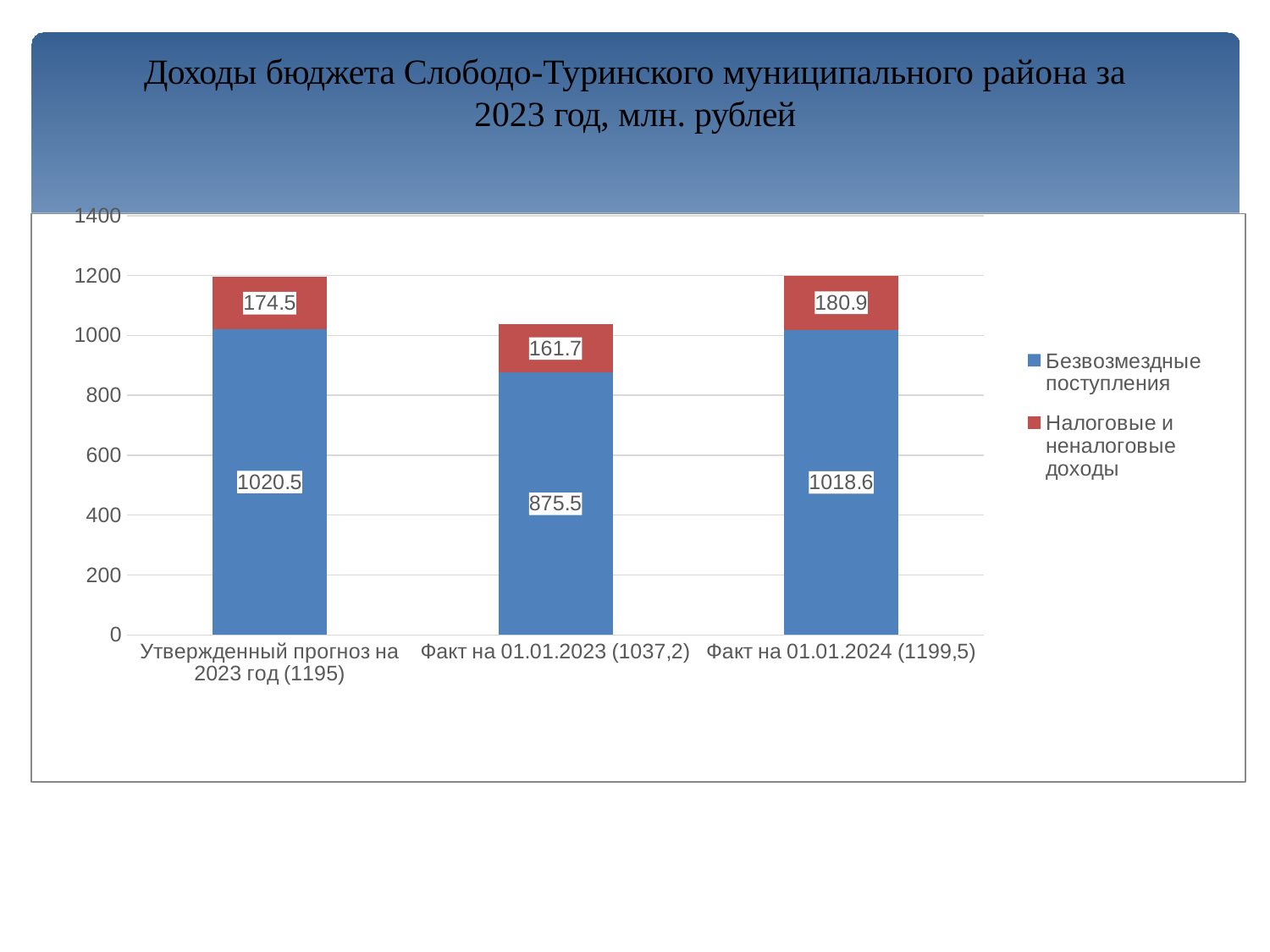
What is the value of Безвозмездные поступления for Утвержденный прогноз на 2023 год (1195)? 1020.5 How many series does the legend list? 2 How many categories are shown on the x axis? 3 Which category has the lowest value for Безвозмездные поступления? Факт на 01.01.2023 (1037,2) What is the title of the chart? Доходы бюджета Слободо-Туринского муниципального района за 2023 год, млн. рублей What is the difference between Налоговые и неналоговые доходы for Факт на 01.01.2024 (1199,5) and Факт на 01.01.2023 (1037,2)? 19.2 What kind of chart is shown on the slide? Stacked bar chart What is the value of Налоговые и неналоговые доходы for Факт на 01.01.2024 (1199,5)? 180.9 Which is larger: Безвозмездные поступления for Утвержденный прогноз на 2023 год (1195) or for Факт на 01.01.2024 (1199,5)? Утвержденный прогноз на 2023 год (1195) Which category has the highest value for Налоговые и неналоговые доходы? Факт на 01.01.2024 (1199,5) What is the value of Безвозмездные поступления for Факт на 01.01.2023 (1037,2)? 875.5 What is the total of the stacked bar for Факт на 01.01.2023 (1037,2)? 1037.2